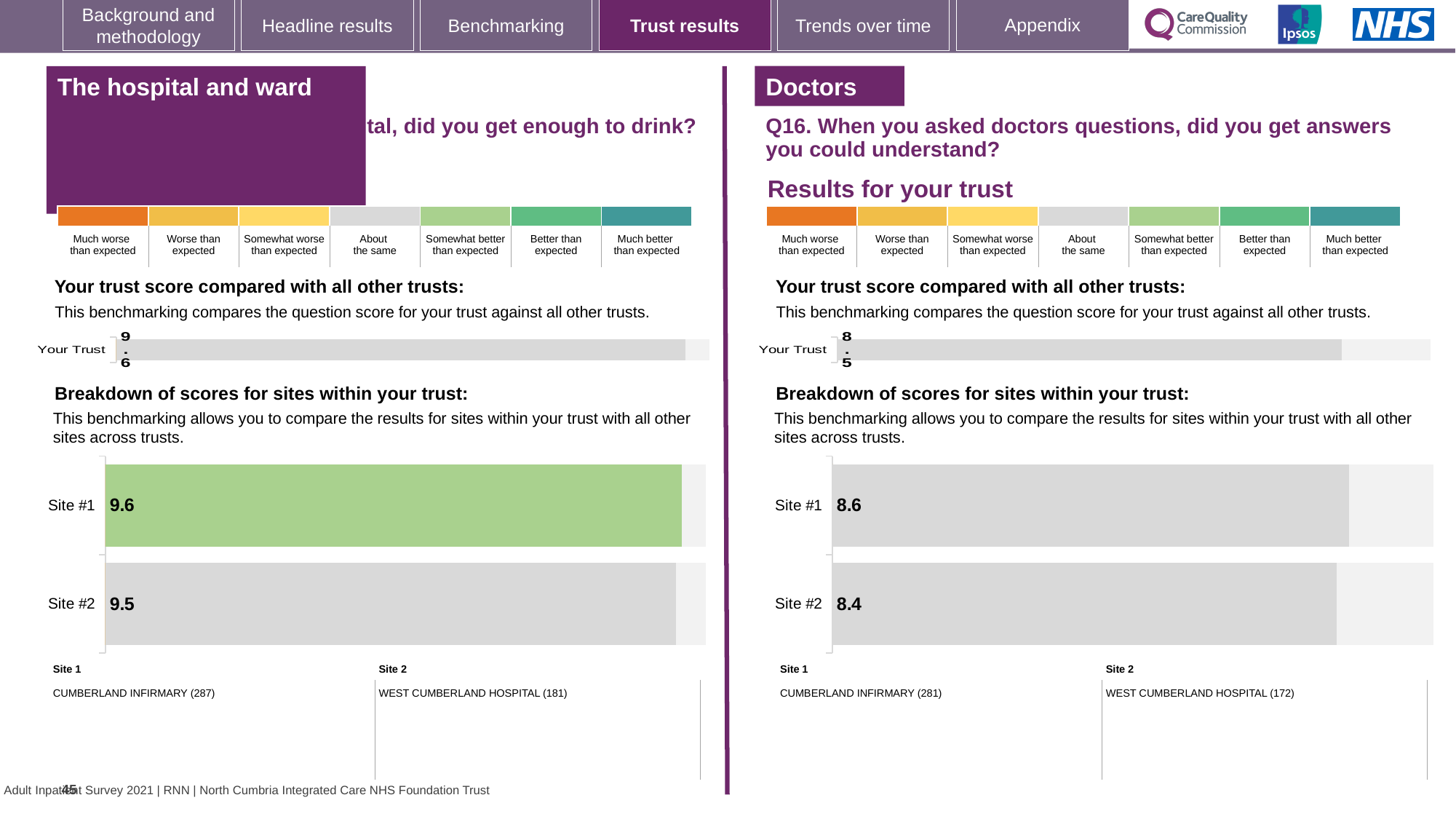
On the left-hand 'Breakdown of scores for sites within your trust' chart (The hospital and ward section), what is the score for Site #2? 9.5 On the Q16 'Breakdown of scores for sites within your trust' chart (Doctors section), what is the score for Site #2? 8.4 On the Q16 'Breakdown of scores for sites within your trust' chart (Doctors section), what is the score for Site #1? 8.6 On the Q16 'Your trust score compared with all other trusts' chart (Doctors section), what is the score shown for Your Trust? 8.5 On the Q16 site breakdown chart (Doctors section), which site has the higher score? Site #1 What kind of chart is the Q16 'Breakdown of scores for sites within your trust' chart (Doctors section)? Bar chart On the left-hand site breakdown chart (The hospital and ward section), what is the difference between the Site #1 and Site #2 scores? 0.1 How many sites are shown on the Q16 site breakdown chart (Doctors section)? 2 On the left-hand 'Breakdown of scores for sites within your trust' chart (The hospital and ward section), what is the score for Site #1? 9.6 On the left-hand 'Your trust score compared with all other trusts' chart (The hospital and ward section), what is the score shown for Your Trust? 9.6 On the left-hand site breakdown chart (The hospital and ward section), which site's bar is coloured green? Site #1 On the Q16 site breakdown chart (Doctors section), what is the difference between the Site #1 and Site #2 scores? 0.2